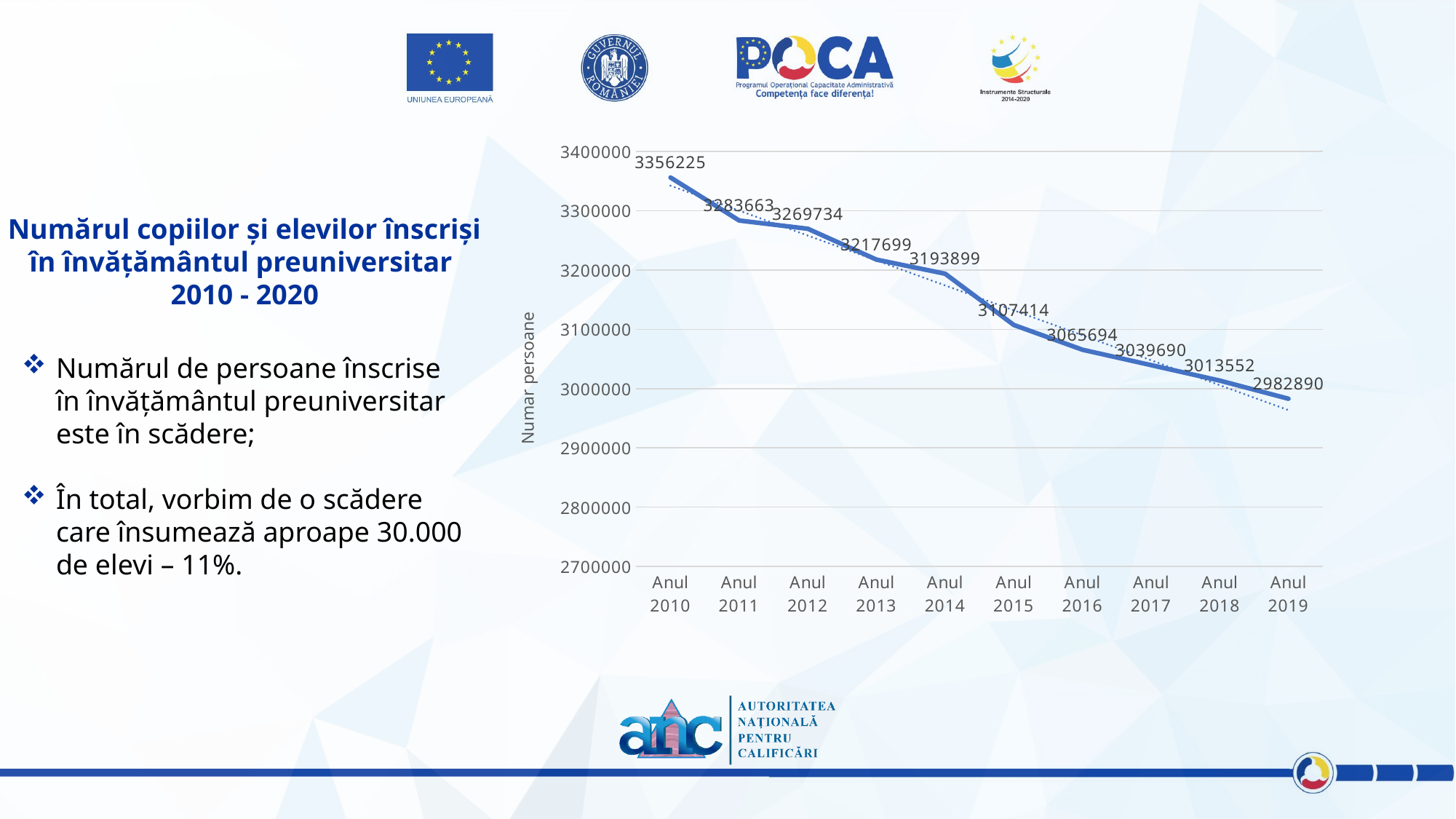
Which year has the lowest value? Anul 2019 How many years are plotted on the x axis? 10 Which year has the highest value? Anul 2010 What is the value for Anul 2010? 3356225 What is the difference between the values for Anul 2010 and Anul 2019? 373335 What is the value for Anul 2015? 3107414 What is the value for Anul 2019? 2982890 Do the values rise or fall from Anul 2010 to Anul 2019? fall What type of chart is shown on the slide? line chart Which is larger, the value for Anul 2013 or the value for Anul 2016? Anul 2013 Is the value for Anul 2017 greater or less than 3000000? greater What is the label of the vertical axis? Numar persoane